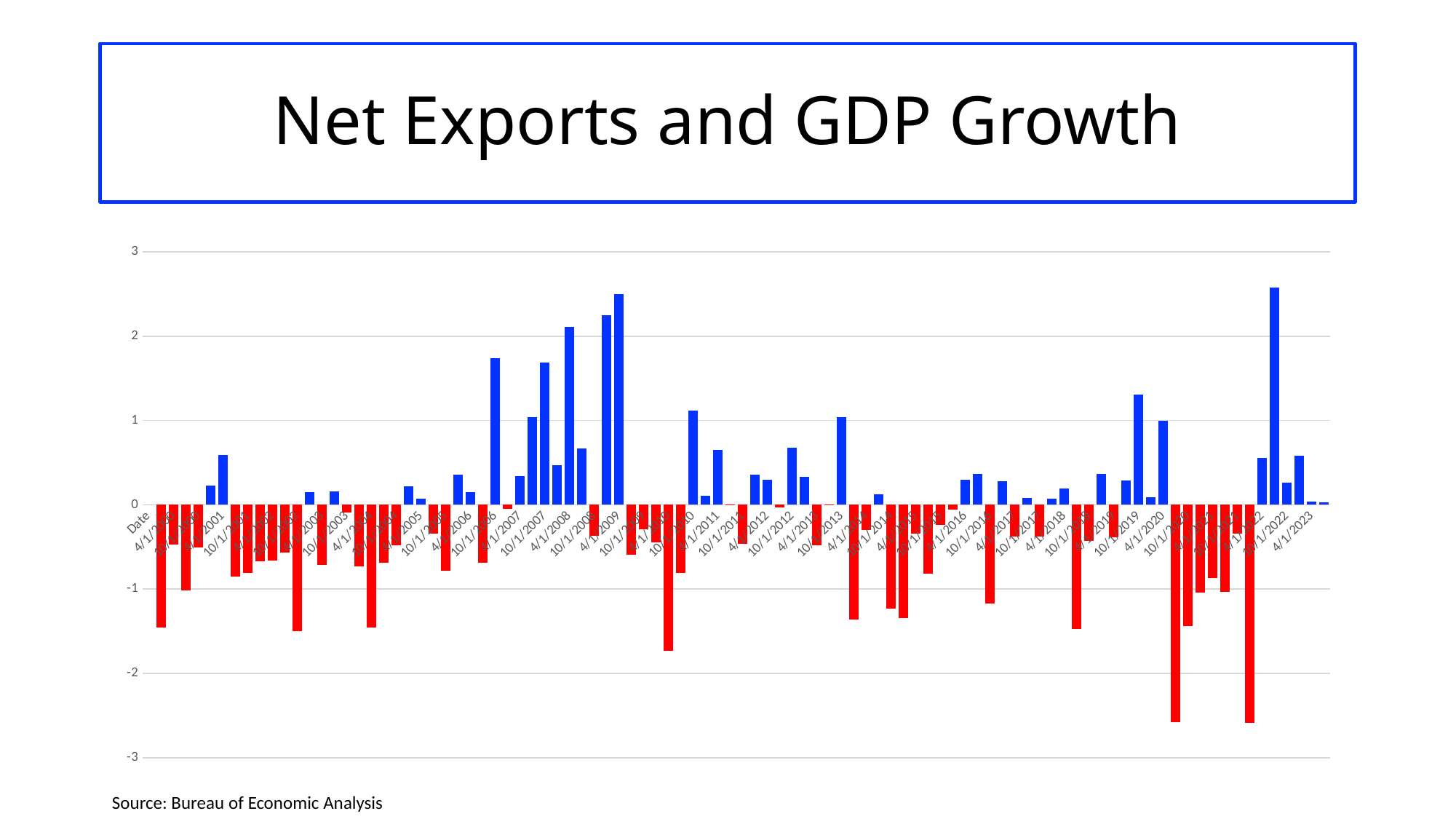
Is the highest value plotted in the chart greater or less than 3? less Is the lowest value plotted in the chart greater or less than -2? less What is the title of the chart on the slide? Net Exports and GDP Growth What colour are the bars with negative values in the chart? red Is the highest value plotted in the chart greater or less than 2? greater What kind of chart is shown on the slide? bar chart Does the chart contain both positive and negative values? yes